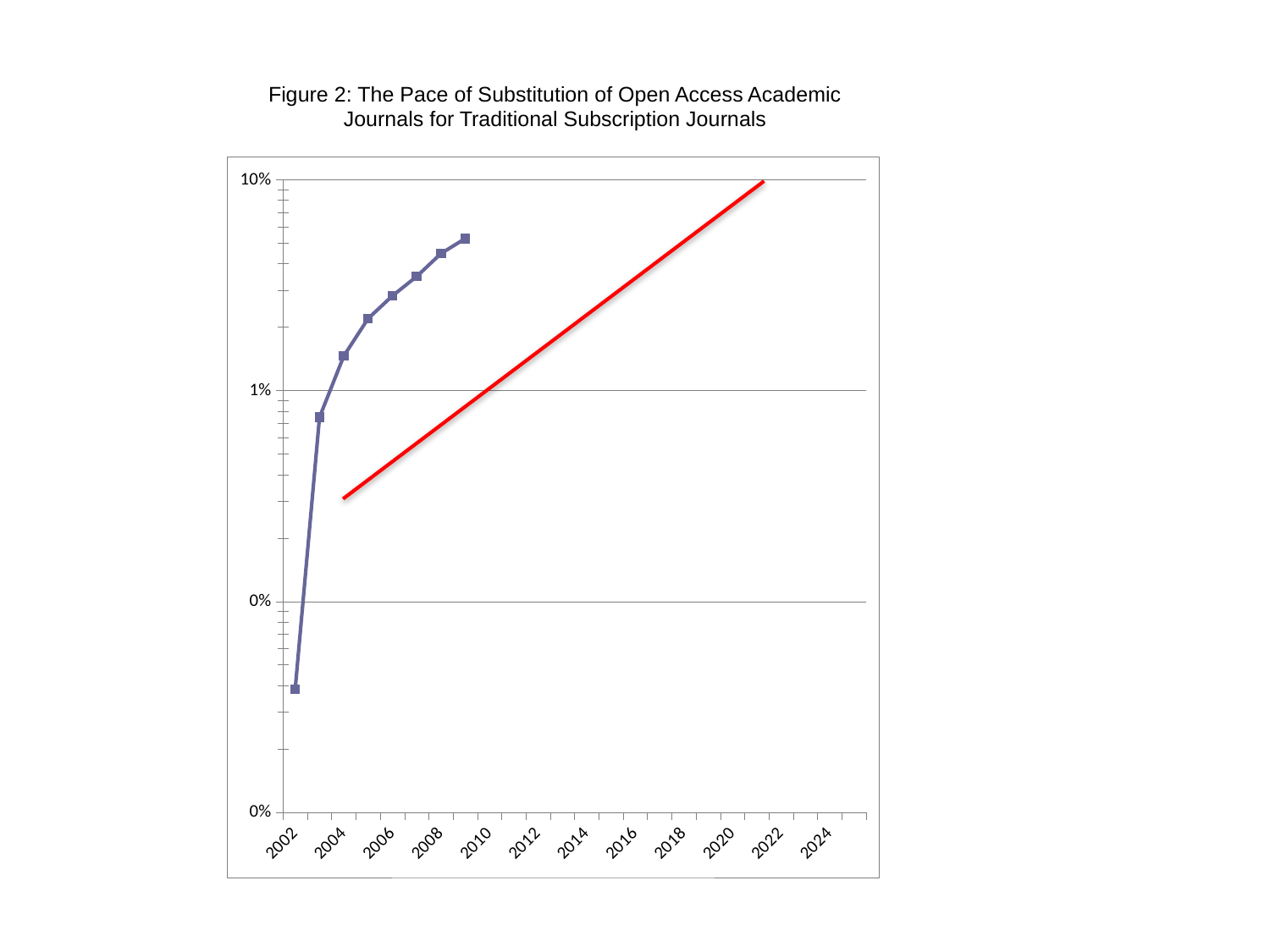
Which year has the lowest value on the blue line? 2002 What kind of chart is shown on the slide? line chart Which year has the highest value on the blue line? 2009 Does the blue line rise or fall from 2002 to 2009? rise How many lines are plotted on the chart? 2 Is the value on the blue line for 2009 greater or less than 10%? less Does the red line rise or fall along the x axis? rise Is the value on the blue line for 2003 greater or less than 1%? less How many data points (markers) are plotted on the blue line? 8 Is the value on the blue line for 2004 greater or less than 1%? greater What is the highest value labelled on the y axis? 10% What is the title of the chart? Figure 2: The Pace of Substitution of Open Access Academic Journals for Traditional Subscription Journals